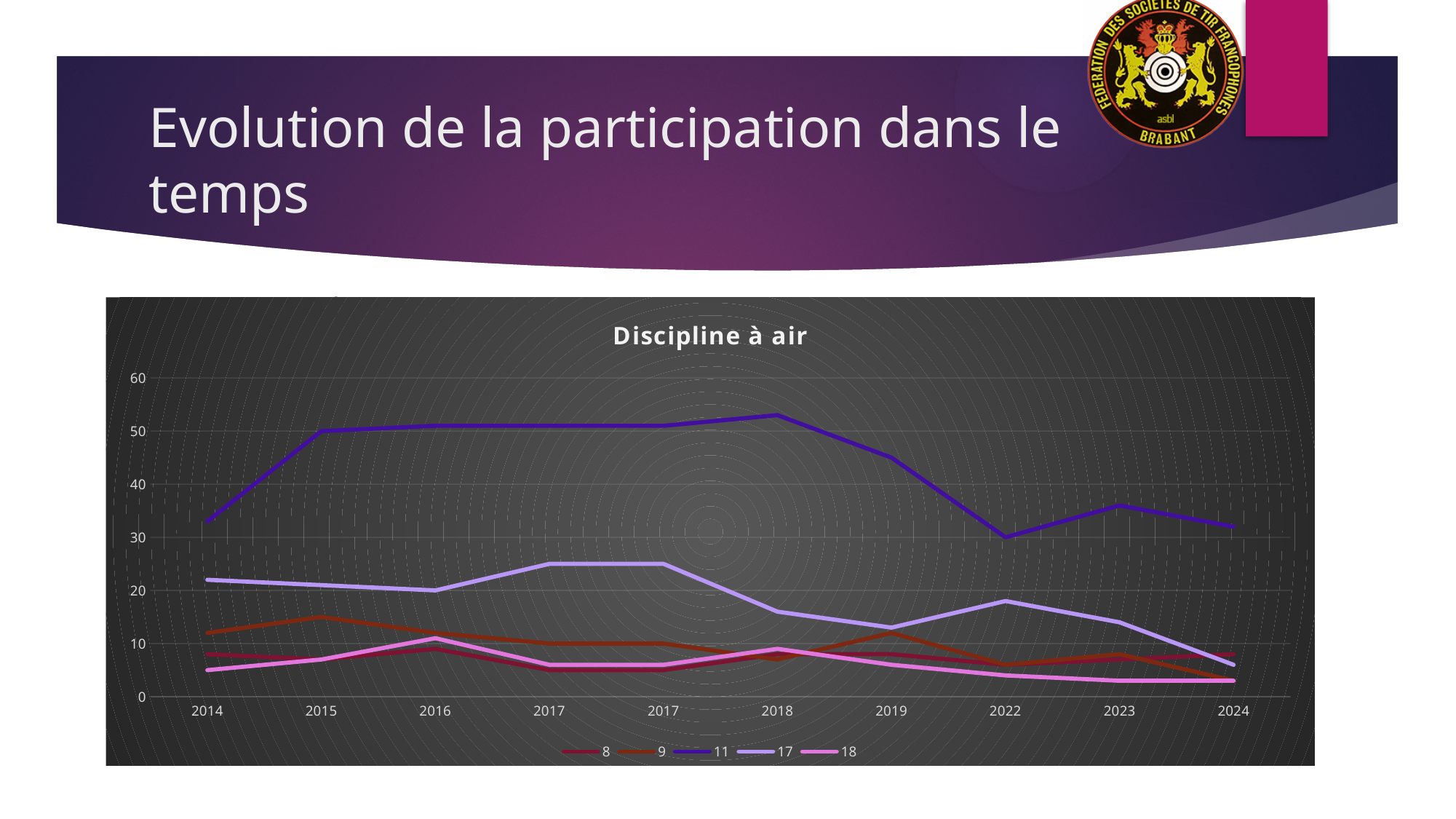
What is the title of the chart? Discipline à air Does the value for series 11 rise or fall between 2018 and 2022? fall Is the value for series 11 in 2018 greater or less than 50? greater Is the value for series 9 in 2015 greater or less than 10? greater Is the value for series 17 in 2024 greater or less than 10? less What kind of chart is shown on the slide? line chart How many points are labelled along the x axis? 10 Which is larger in 2016, the value for series 11 or series 17? 11 Which series has the highest value in 2018? 11 How many series does the legend list? 5 In which year does series 11 reach its highest value? 2018